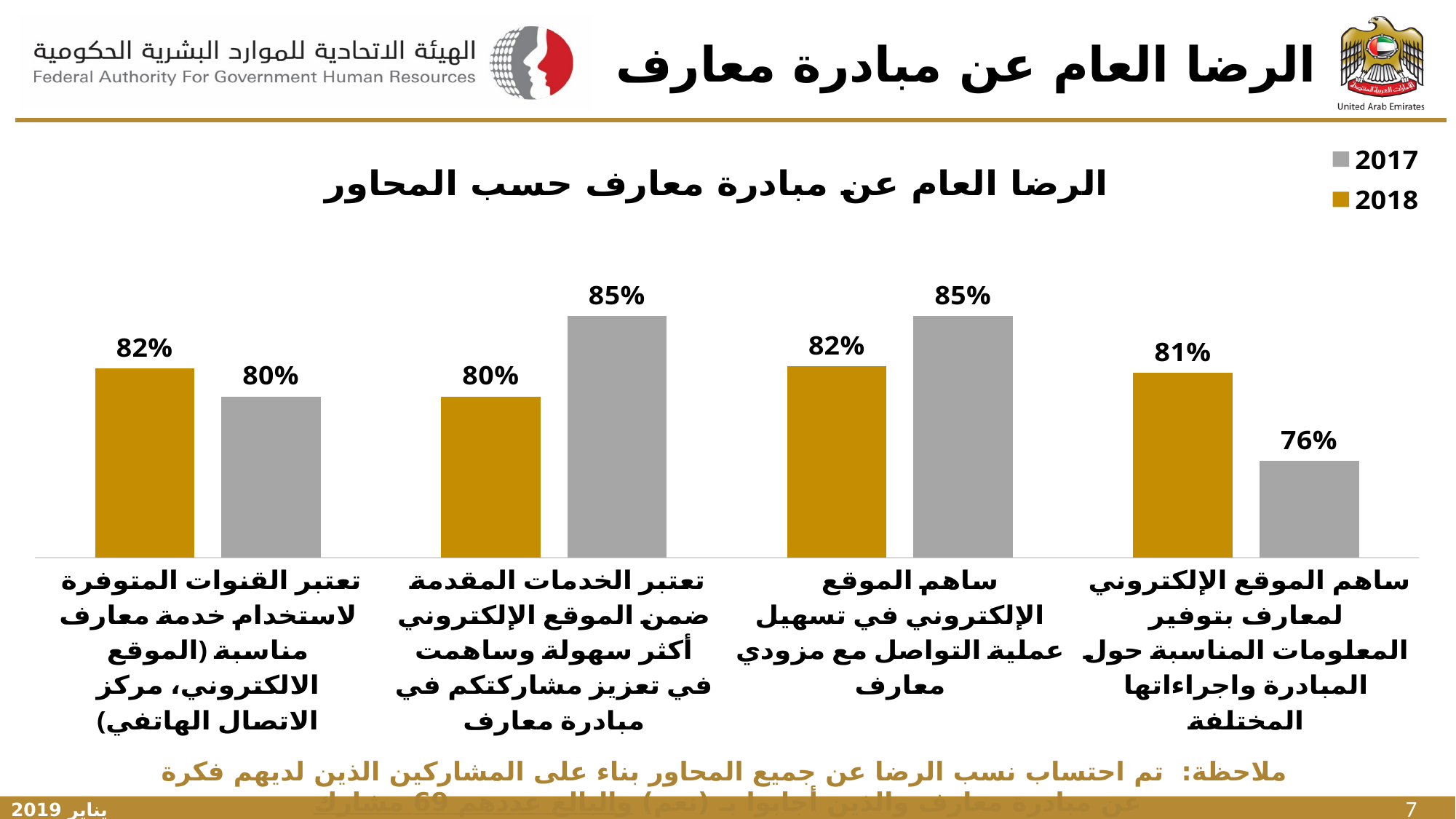
What is the 2017 value for the category 'ساهم الموقع الإلكتروني في تسهيل عملية التواصل مع مزودي معارف'? 85% How many categories are shown on the x axis of the chart? 4 Which category has the lowest 2017 value? ساهم الموقع الإلكتروني لمعارف بتوفير المعلومات المناسبة حول المبادرة واجراءاتها المختلفة How many series does the legend list? 2 What type of chart is shown on the slide? bar chart Which colour represents the 2018 series in the chart? gold For the category 'تعتبر الخدمات المقدمة ضمن الموقع الإلكتروني أكثر سهولة وساهمت في تعزيز مشاركتكم في مبادرة معارف', which year has the larger value, 2017 or 2018? 2017 What is the 2017 value for the category 'ساهم الموقع الإلكتروني لمعارف بتوفير المعلومات المناسبة حول المبادرة واجراءاتها المختلفة'? 76% What is the 2018 value for the category 'ساهم الموقع الإلكتروني لمعارف بتوفير المعلومات المناسبة حول المبادرة واجراءاتها المختلفة'? 81% What is the 2018 value for the category 'تعتبر القنوات المتوفرة لاستخدام خدمة معارف مناسبة'? 82% What is the difference between the 2018 and 2017 values for the category 'ساهم الموقع الإلكتروني لمعارف بتوفير المعلومات المناسبة حول المبادرة واجراءاتها المختلفة'? 5% What is the 2018 value for the category 'تعتبر الخدمات المقدمة ضمن الموقع الإلكتروني أكثر سهولة وساهمت في تعزيز مشاركتكم في مبادرة معارف'? 80%